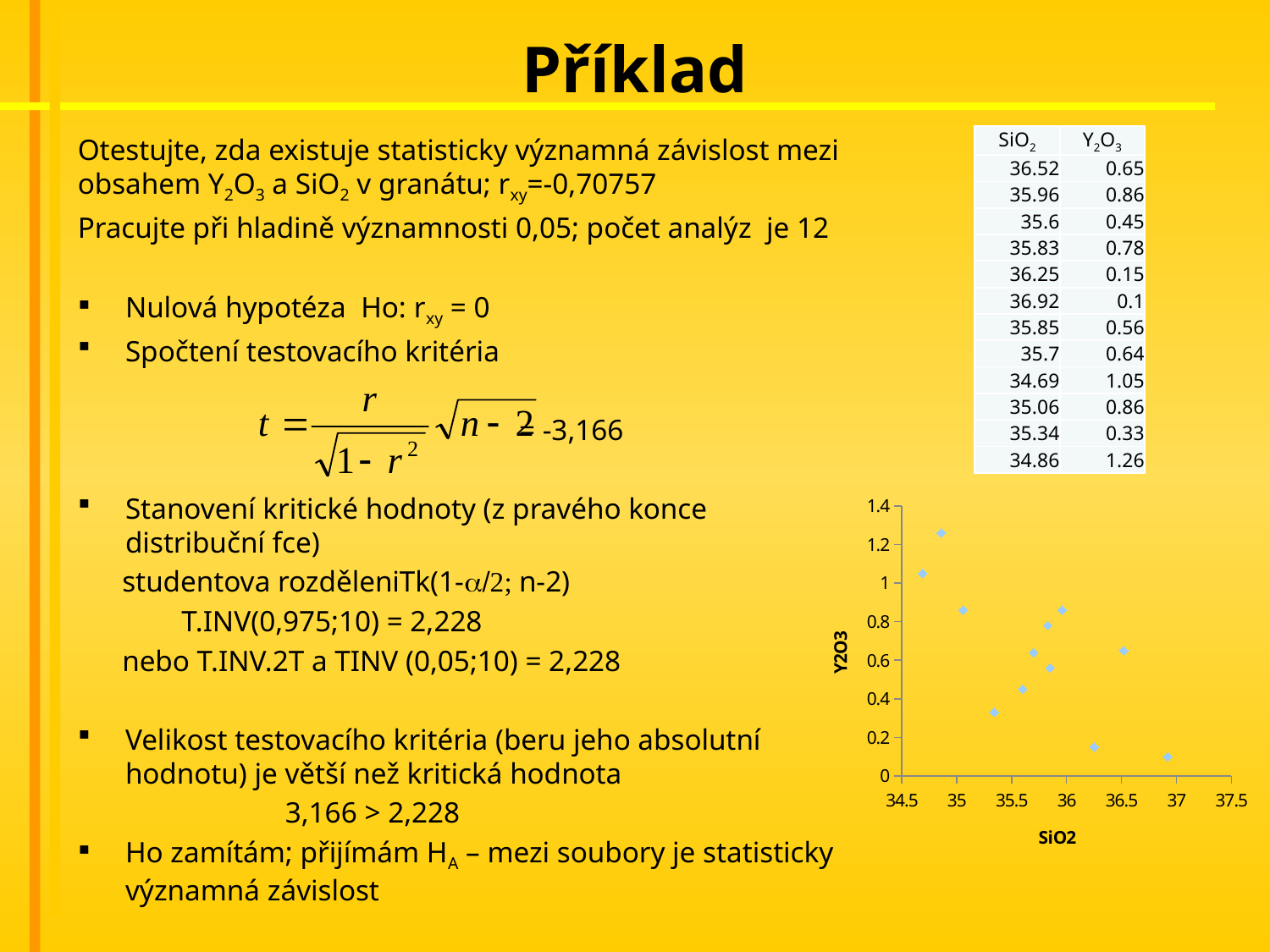
Is the Y2O3 value for the point with the lowest SiO2 (about 34.7) greater or less than 1? greater According to the data table, what is the highest Y2O3 value plotted? 1.26 What is the highest tick value shown on the vertical (Y2O3) axis? 1.4 What is the label of the horizontal axis of the scatter chart? SiO2 What kind of chart is shown on the slide? scatter chart What is the label of the vertical axis of the scatter chart? Y2O3 As SiO2 increases along the x axis, do the Y2O3 values generally rise or fall? fall Which has the larger Y2O3 value: the point near SiO2 = 35 or the point near SiO2 = 37? the point near SiO2 = 35 Is the highest plotted Y2O3 value greater or less than 1.2? greater According to the data table, what is the lowest Y2O3 value plotted? 0.1 How many data points are plotted in the scatter chart? 12 Is the Y2O3 value for the point with the highest SiO2 (about 36.9) greater or less than 0.2? less